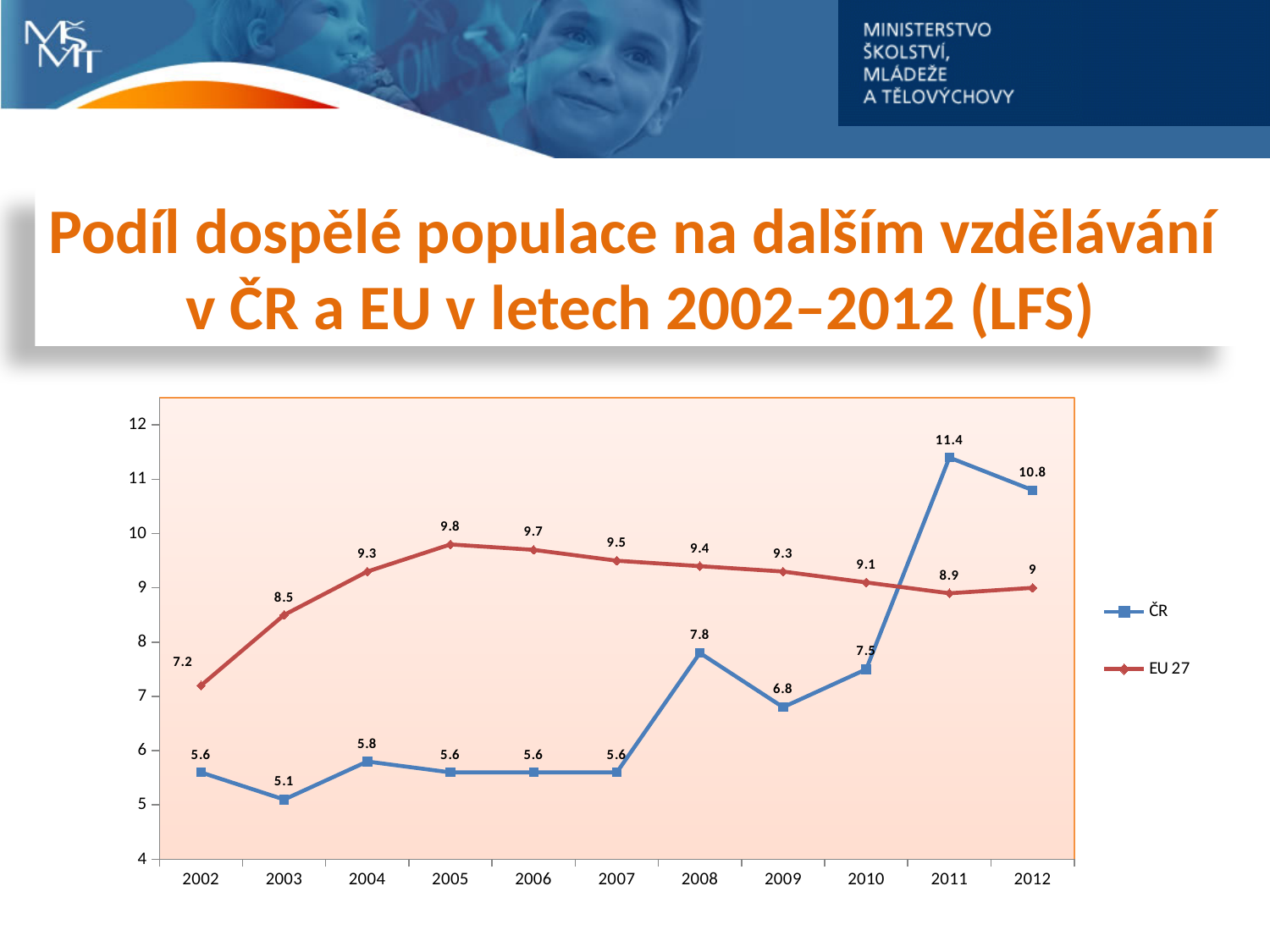
Which series has the larger value in 2010, ČR or EU 27? EU 27 What is the difference between the ČR and EU 27 values in 2012? 1.8 Does the EU 27 series rise or fall from 2005 to 2011? fall What is the value for ČR in 2011? 11.4 What is the value for ČR in 2003? 5.1 How many series does the legend list? 2 In which year is the EU 27 value highest? 2005 What type of chart is shown on the slide? line chart In which year is the ČR value lowest? 2003 Which series is drawn in red? EU 27 What is the value for EU 27 in 2005? 9.8 How many years are shown on the x axis? 11